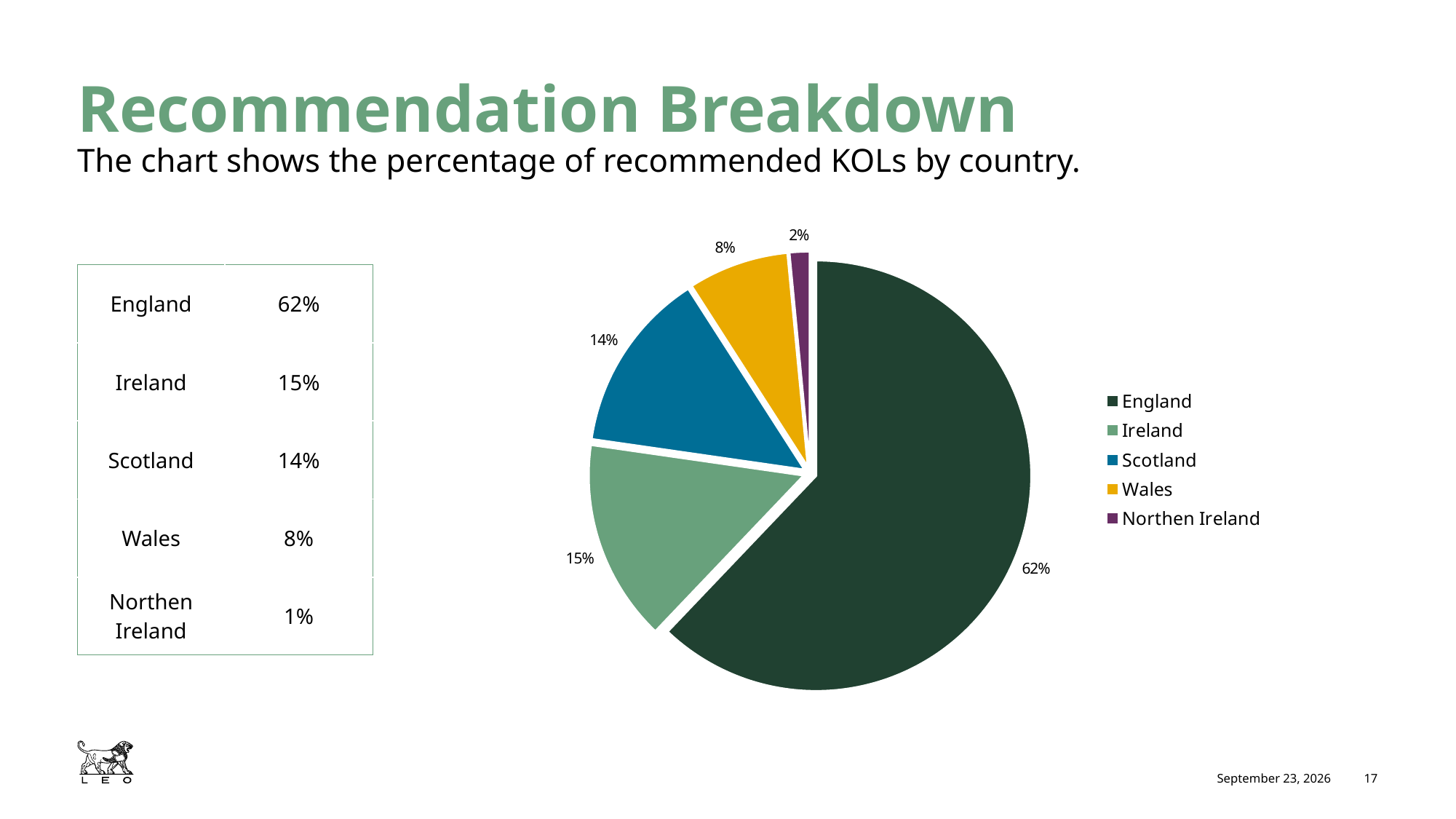
How many slices does the pie chart have? 5 How many entries does the legend of the pie chart list? 5 What percentage of the pie chart does England account for? 62% What kind of chart is shown on the slide? pie chart What is the difference between the England and Ireland slices in the pie chart? 47% Which country has the largest slice of the pie chart? England What colour is the Wales slice in the pie chart? yellow What is the value shown for Wales in the pie chart? 8% Which is larger in the pie chart, the Scotland slice or the Wales slice? Scotland What is the value shown for Scotland in the pie chart? 14% Which country has the smallest slice of the pie chart? Northen Ireland What is the value shown for Ireland in the pie chart? 15%